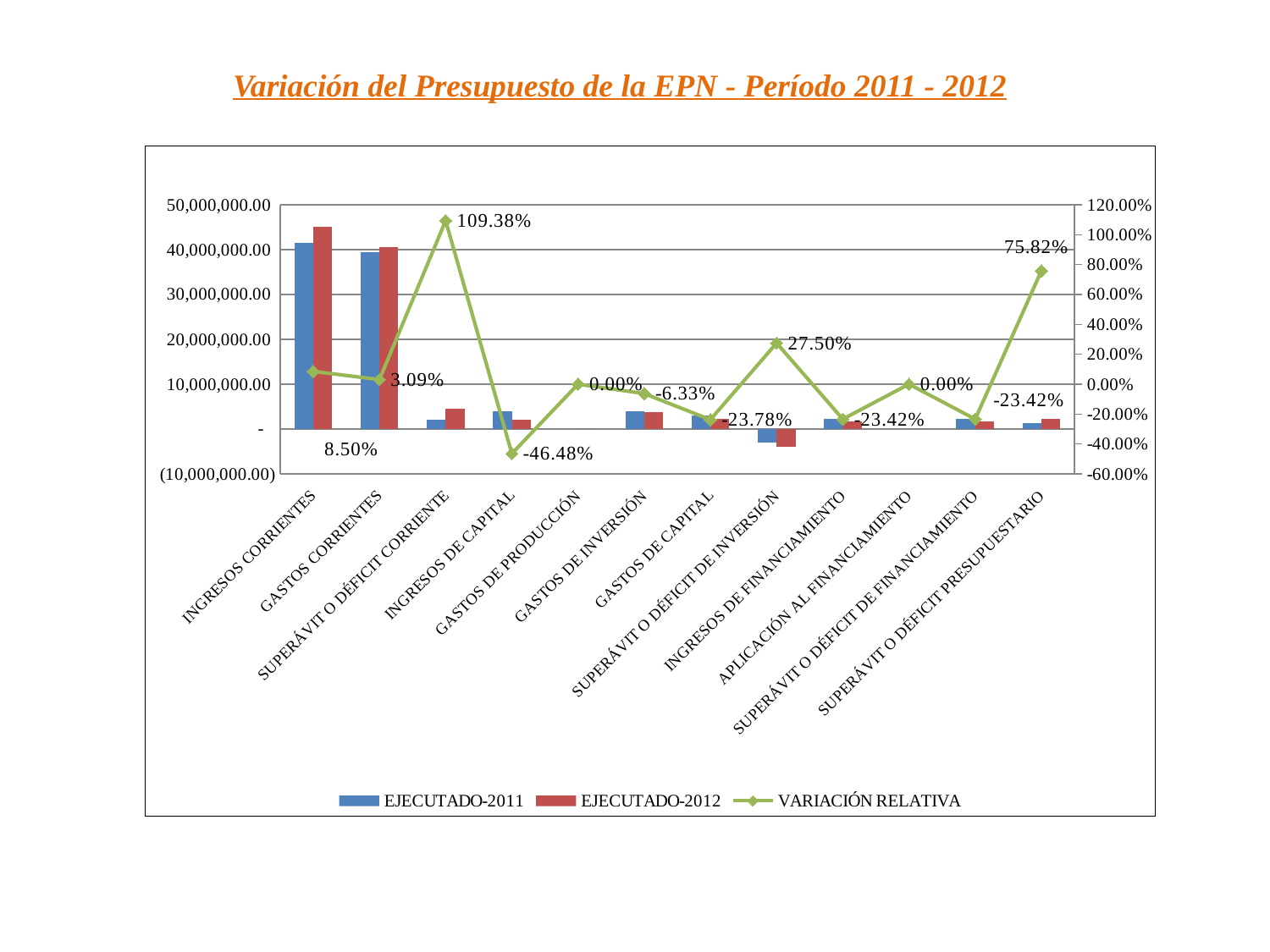
What is the difference between the VARIACIÓN RELATIVA for SUPERÁVIT O DÉFICIT CORRIENTE and for SUPERÁVIT O DÉFICIT PRESUPUESTARIO? 33.56% Is the EJECUTADO-2012 value for INGRESOS CORRIENTES greater or less than 40,000,000.00? greater What kind of chart is shown on the slide? Combination bar and line chart How many categories are shown on the x axis? 12 What is the VARIACIÓN RELATIVA value for INGRESOS CORRIENTES? 8.50% Which category has the highest VARIACIÓN RELATIVA? SUPERÁVIT O DÉFICIT CORRIENTE Which category has the lowest VARIACIÓN RELATIVA? INGRESOS DE CAPITAL For INGRESOS CORRIENTES, which is larger: EJECUTADO-2011 or EJECUTADO-2012? EJECUTADO-2012 What is the VARIACIÓN RELATIVA value for SUPERÁVIT O DÉFICIT CORRIENTE? 109.38% What is the VARIACIÓN RELATIVA value for INGRESOS DE CAPITAL? -46.48% What is the VARIACIÓN RELATIVA value for SUPERÁVIT O DÉFICIT PRESUPUESTARIO? 75.82% How many series does the legend list? 3